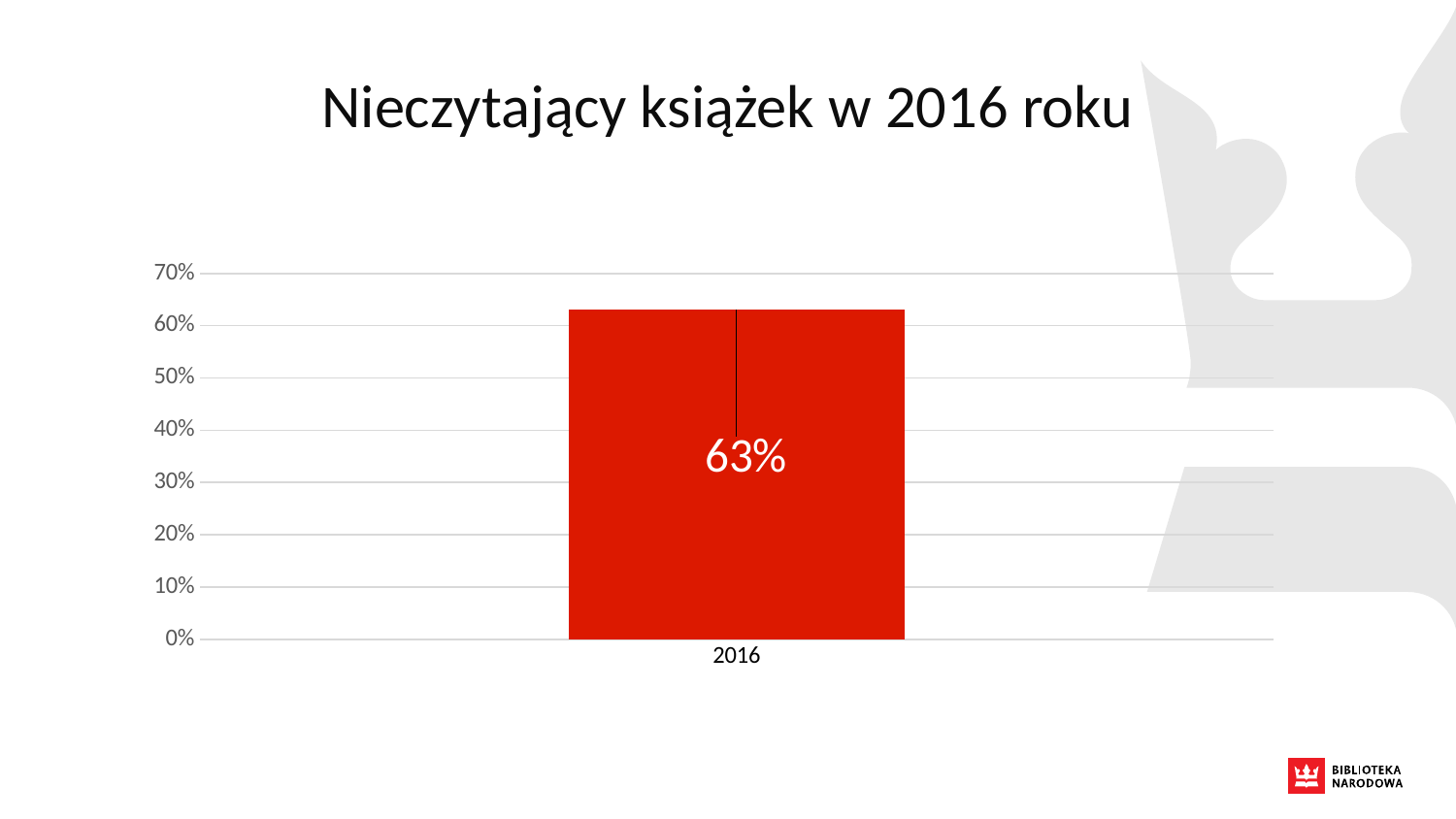
How many bars does the chart have? 1 What colour is the bar in the chart? red Is the value for 2016 greater or less than 50%? greater Is the value for 2016 greater or less than 70%? less What is the highest value shown on the vertical axis? 70% What is the title of the chart? Nieczytający książek w 2016 roku What kind of chart is shown on the slide? bar chart What category label appears on the x axis? 2016 What is the value shown for 2016? 63%